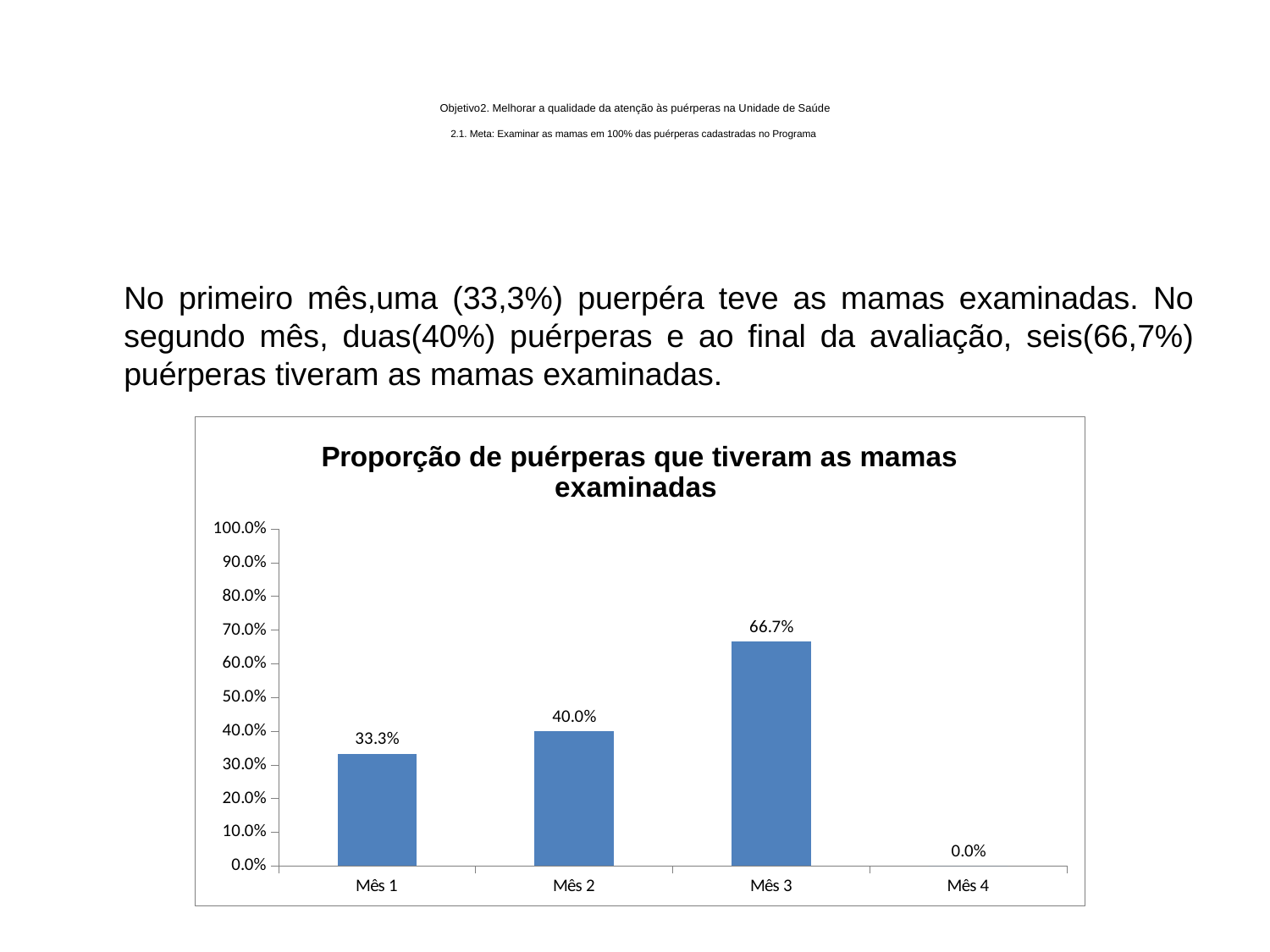
What is the value for Mês 3? 66.7% What is the title of the chart? Proporção de puérperas que tiveram as mamas examinadas Which month has the lowest proportion? Mês 4 How many months are shown on the x axis? 4 What is the value for Mês 1? 33.3% What is the difference between the values for Mês 3 and Mês 1? 33.4% What is the value for Mês 4? 0.0% Is the value for Mês 3 greater or less than 50.0%? greater Which month has the highest proportion? Mês 3 Which is larger, the value for Mês 2 or the value for Mês 1? Mês 2 What is the value for Mês 2? 40.0% What kind of chart is shown? bar chart